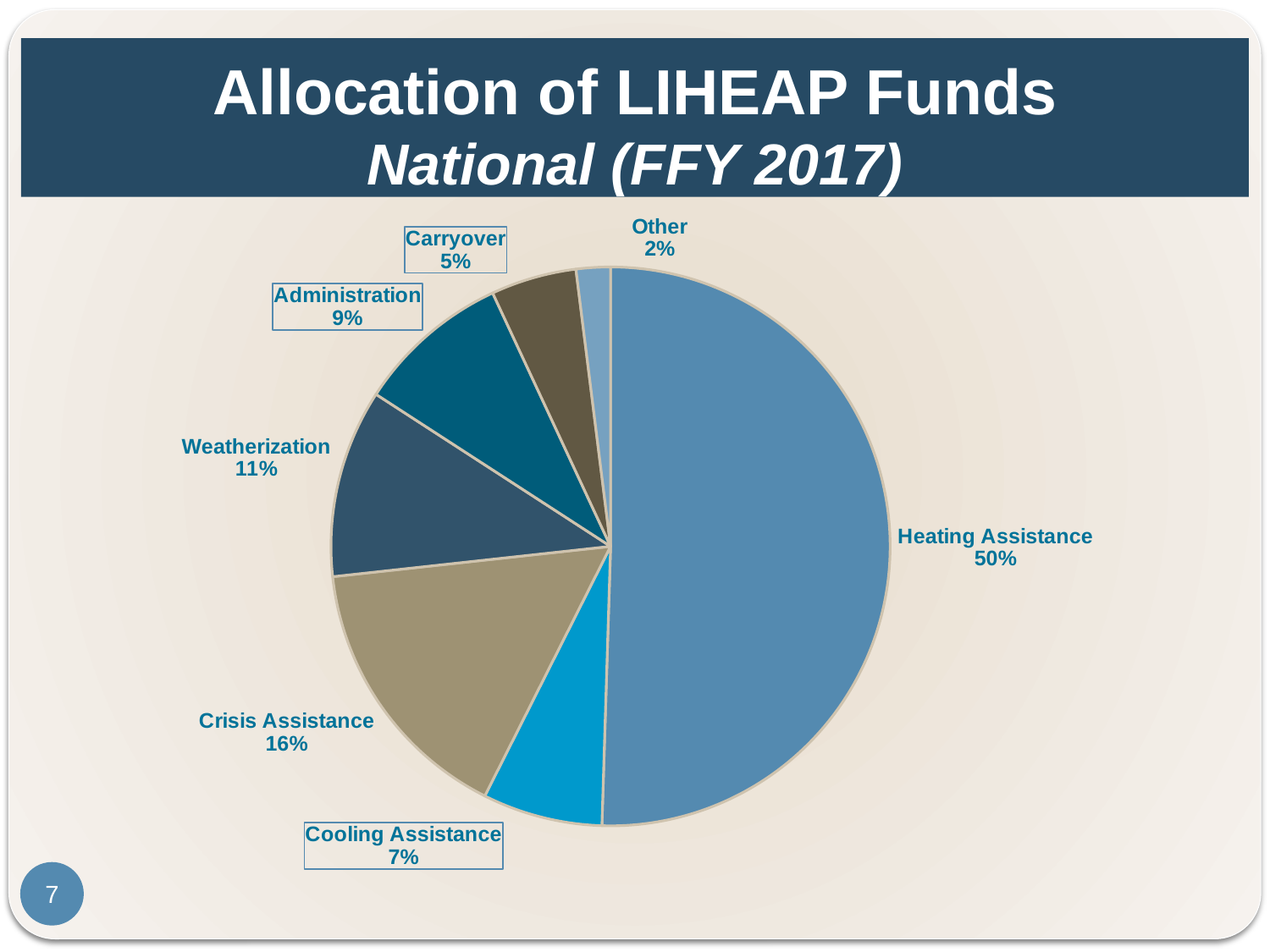
What share of funds goes to Cooling Assistance? 7% What percentage is allocated to Administration? 9% What is the difference in percentage points between Heating Assistance and Crisis Assistance? 34 What share is shown for Weatherization? 11% What percentage of the pie is Crisis Assistance? 16% What type of chart is shown on the slide? Pie chart Which category has the largest slice of the pie? Heating Assistance What share of LIHEAP funds is allocated to Heating Assistance? 50% Which is larger, the Weatherization slice or the Administration slice? Weatherization Which category has the smallest slice of the pie? Other How many categories are shown in the pie chart? 7 What percentage is labelled as Carryover? 5%